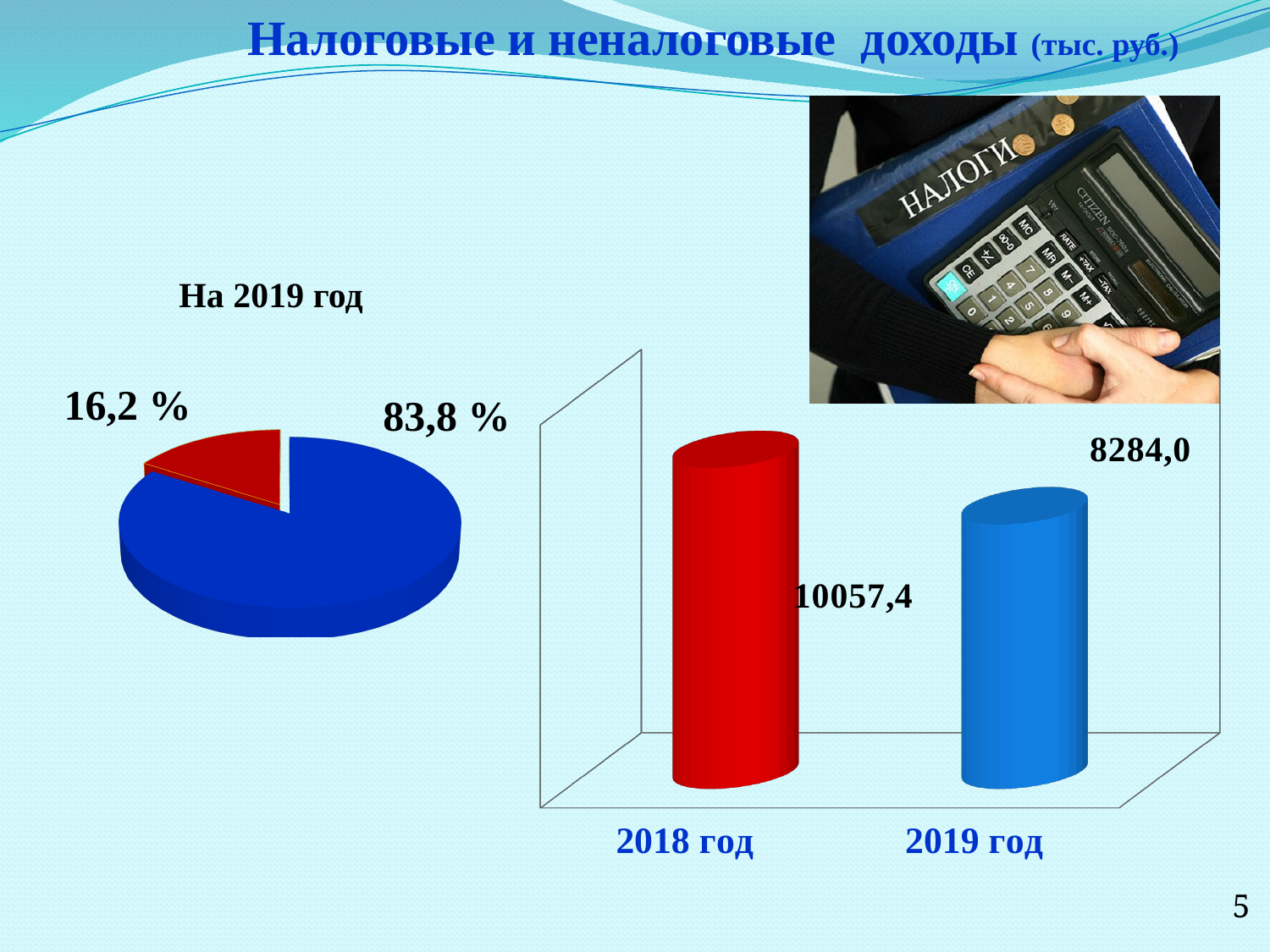
What kind of chart is the chart on the right side of the slide? bar chart On the pie chart 'На 2019 год', what share does the blue slice have? 83,8 % On the bar chart, is the value for 2018 год larger or smaller than the value for 2019 год? larger On the pie chart 'На 2019 год', what share does the red slice have? 16,2 % On the bar chart, do the values rise or fall from 2018 год to 2019 год? fall On the bar chart, which year has the lower value? 2019 год On the bar chart, which year has the higher value? 2018 год On the bar chart, what is the difference between the values for 2018 год and 2019 год? 1773,4 On the bar chart, what is the value for 2018 год? 10057,4 On the bar chart, how many bars are shown? 2 What kind of chart is the chart titled 'На 2019 год'? pie chart On the bar chart, what is the value for 2019 год? 8284,0